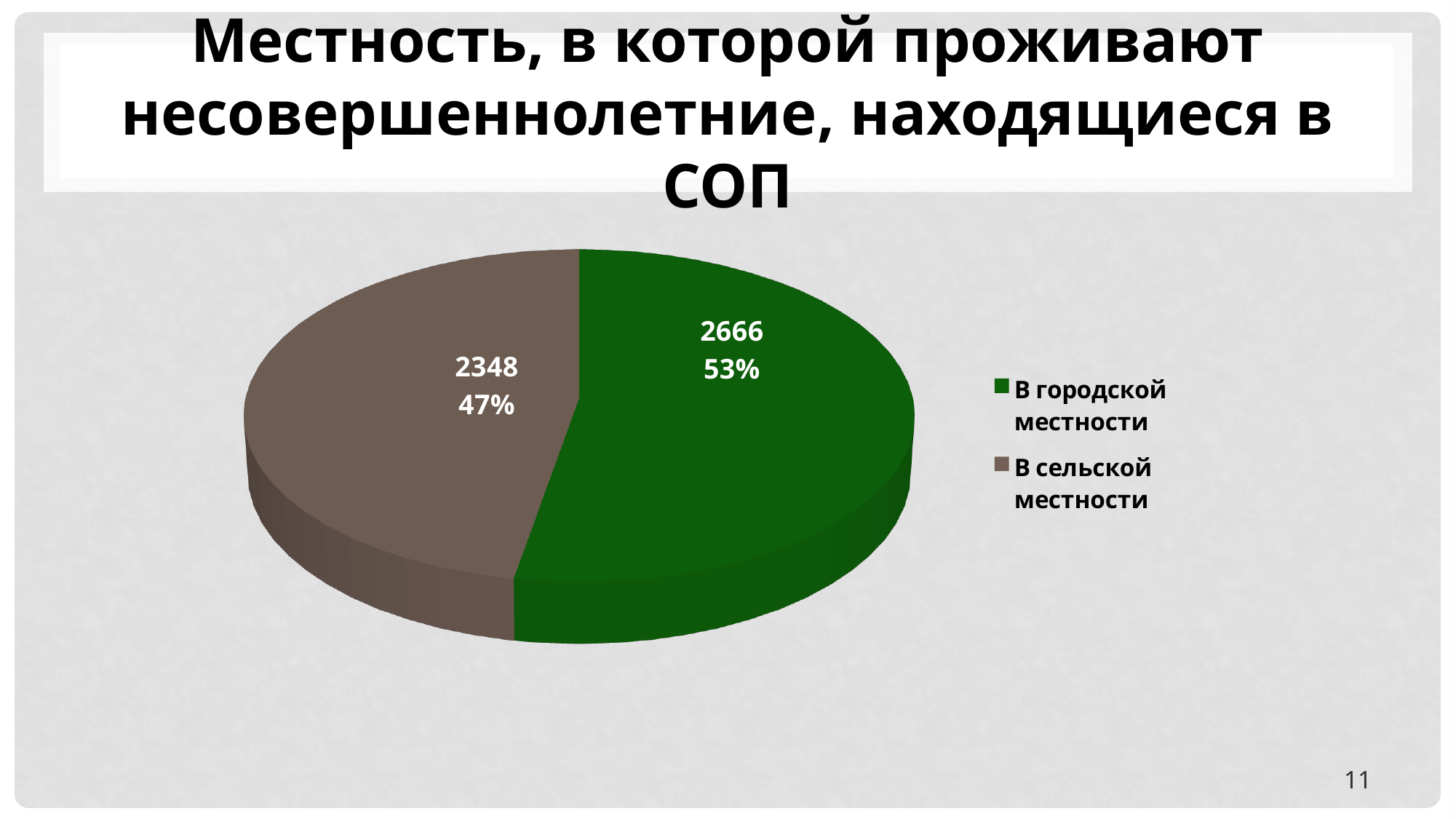
Which is larger: the value for "В городской местности" or "В сельской местности"? В городской местности How many slices does the pie chart have? 2 Which category has the smallest slice? В сельской местности What is the difference between the values for "В городской местности" and "В сельской местности"? 318 What is the value for "В сельской местности"? 2348 What share of the pie does "В городской местности" represent? 53% What is the total of the two slices in the pie chart? 5014 What is the value for "В городской местности"? 2666 What colour is the slice for "В сельской местности"? brown What share of the pie does "В сельской местности" represent? 47% Which category has the largest slice? В городской местности What kind of chart is shown on the slide? pie chart